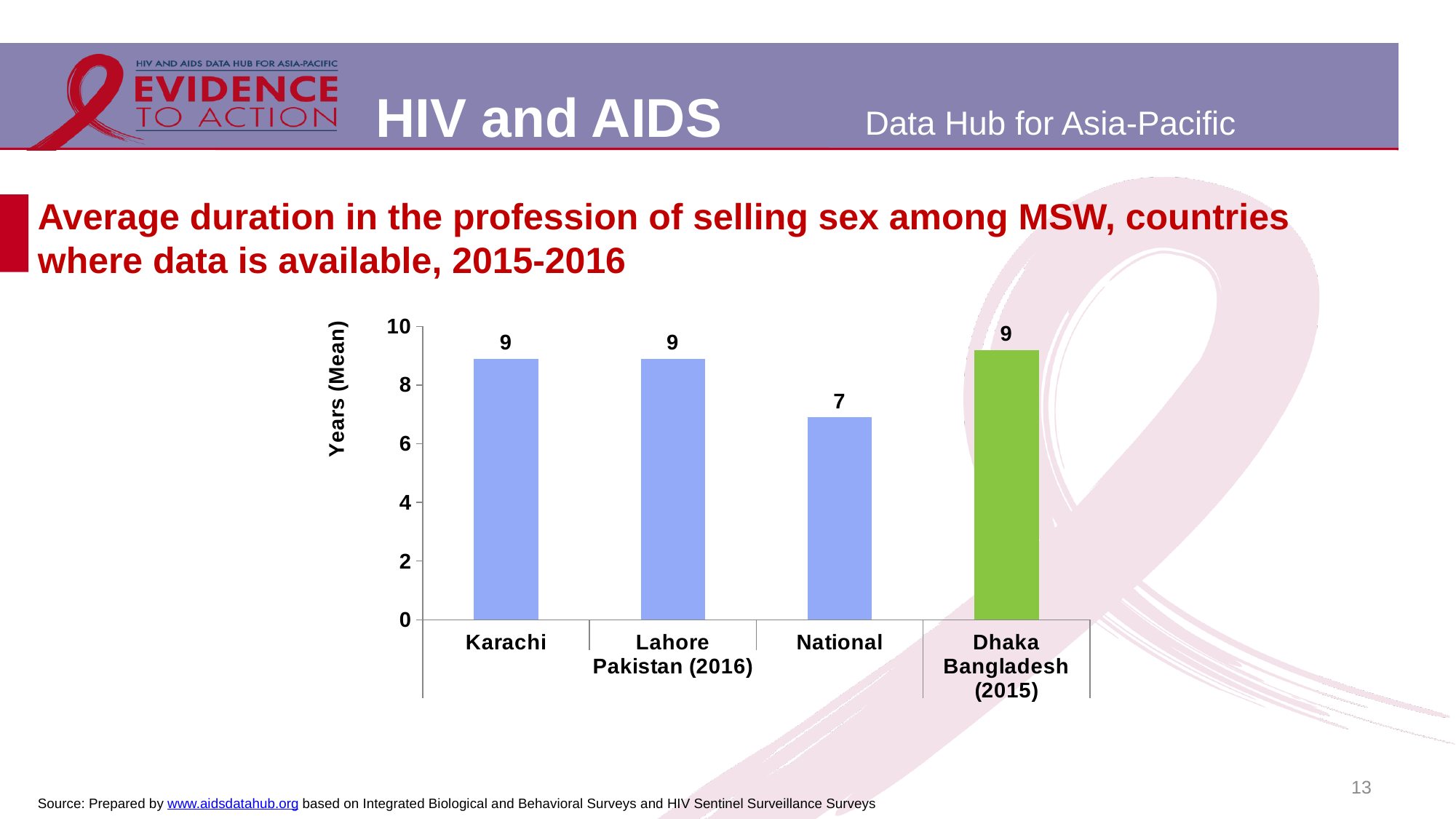
What colour is the bar for Dhaka, Bangladesh? Green What is the value shown for National (Pakistan)? 7 What is the average duration in years for Dhaka, Bangladesh (2015)? 9 What is the difference between the values for Karachi and National? 2 How many bars are shown in the chart? 4 What is the average duration in years for Lahore? 9 Which category has the lowest average duration? National What kind of chart is shown on the slide? Bar chart Which is larger, the value for Lahore or the value for National? Lahore What is the average duration in years for Karachi? 9 What is the label of the vertical axis? Years (Mean) Is the value for National greater or less than 8? less